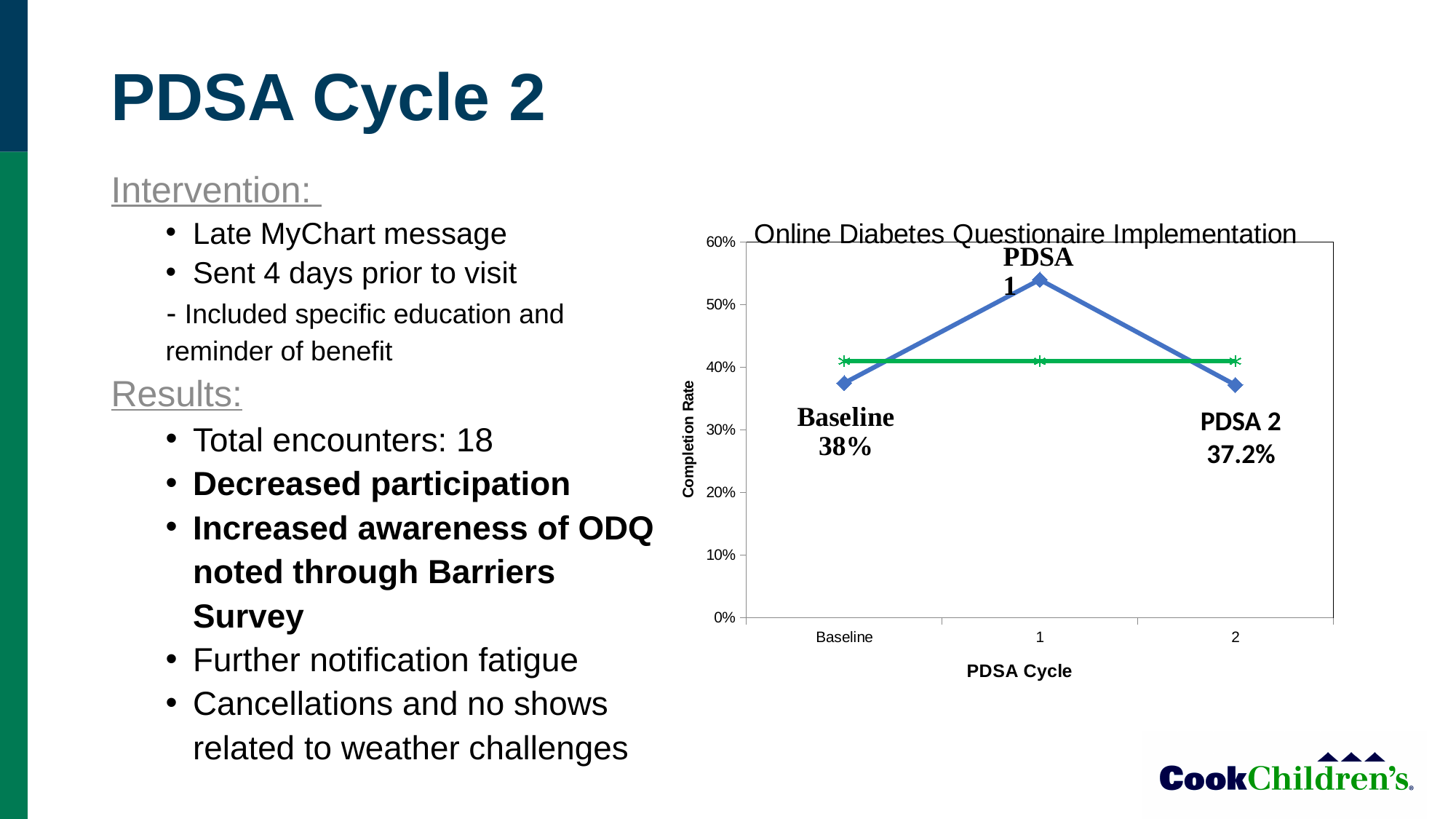
Which point on the blue line has the lowest completion rate? PDSA 2 What is the label of the y axis of the chart? Completion Rate What is the completion rate at Baseline in the Online Diabetes Questionaire Implementation chart? 38% How does the blue line change from Baseline to cycle 1 to cycle 2? Rises then falls Is the flat green line in the chart greater or less than 50%? less Which PDSA cycle has the highest completion rate on the blue line? 1 What is the completion rate for PDSA 2 in the chart? 37.2% Which is larger, the Baseline completion rate or the PDSA 2 completion rate? Baseline How many PDSA cycle categories are shown on the x axis of the chart? 3 What kind of chart is shown on the slide? Line chart What is the difference between the Baseline completion rate and the PDSA 2 completion rate? 0.8% Is the completion rate for PDSA cycle 1 greater or less than 50%? greater